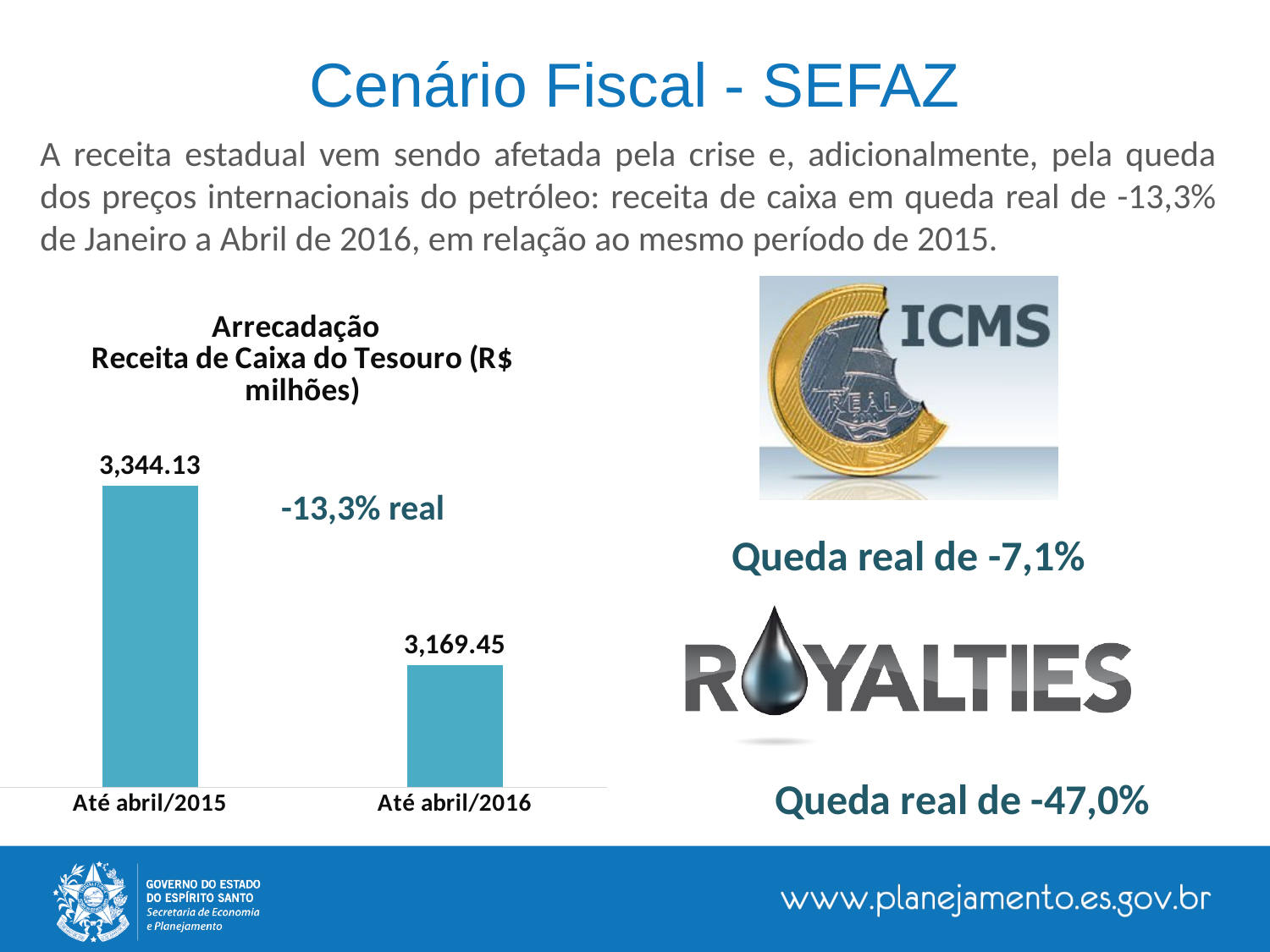
Do the values rise or fall from Até abril/2015 to Até abril/2016? Fall Which category has the lowest value in the chart? Até abril/2016 Which is larger, the value for Até abril/2015 or the value for Até abril/2016? Até abril/2015 Which category has the highest value in the chart? Até abril/2015 What is the value for Até abril/2016 in the chart? 3,169.45 What is the title of the chart? Arrecadação Receita de Caixa do Tesouro (R$ milhões) What is the difference between the values for Até abril/2015 and Até abril/2016? 174.68 What is the value for Até abril/2015 in the chart? 3,344.13 How many categories are shown in the chart? 2 What percentage change is annotated between the two bars in the chart? -13,3% real What kind of chart is shown on the slide? Bar chart